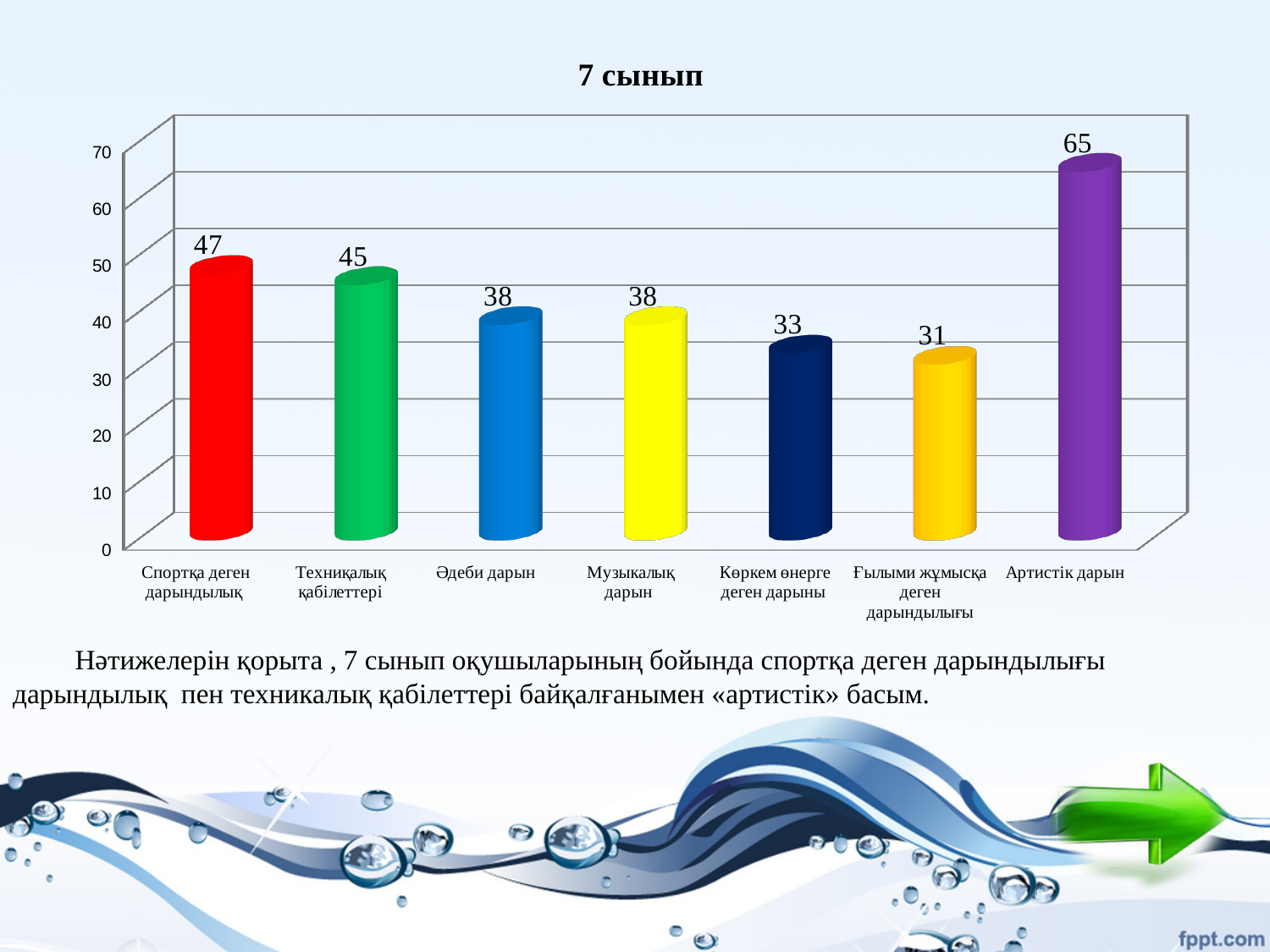
What kind of chart is shown on the slide? bar chart What is the title of the chart? 7 сынып Which category has the lowest value? Ғылыми жұмысқа деген дарындылығы What is the value for Ғылыми жұмысқа деген дарындылығы? 31 Which is larger, the value for Техникалық қабілеттері or the value for Әдеби дарын? Техникалық қабілеттері Which category has the highest value? Артистік дарын Is the value for Музыкалық дарын greater or less than 40? less What is the value for Спортқа деген дарындылық? 47 What is the difference between the values for Артистік дарын and Спортқа деген дарындылық? 18 What is the value for Артистік дарын? 65 What is the value for Көркем өнерге деген дарыны? 33 How many categories are shown on the chart? 7